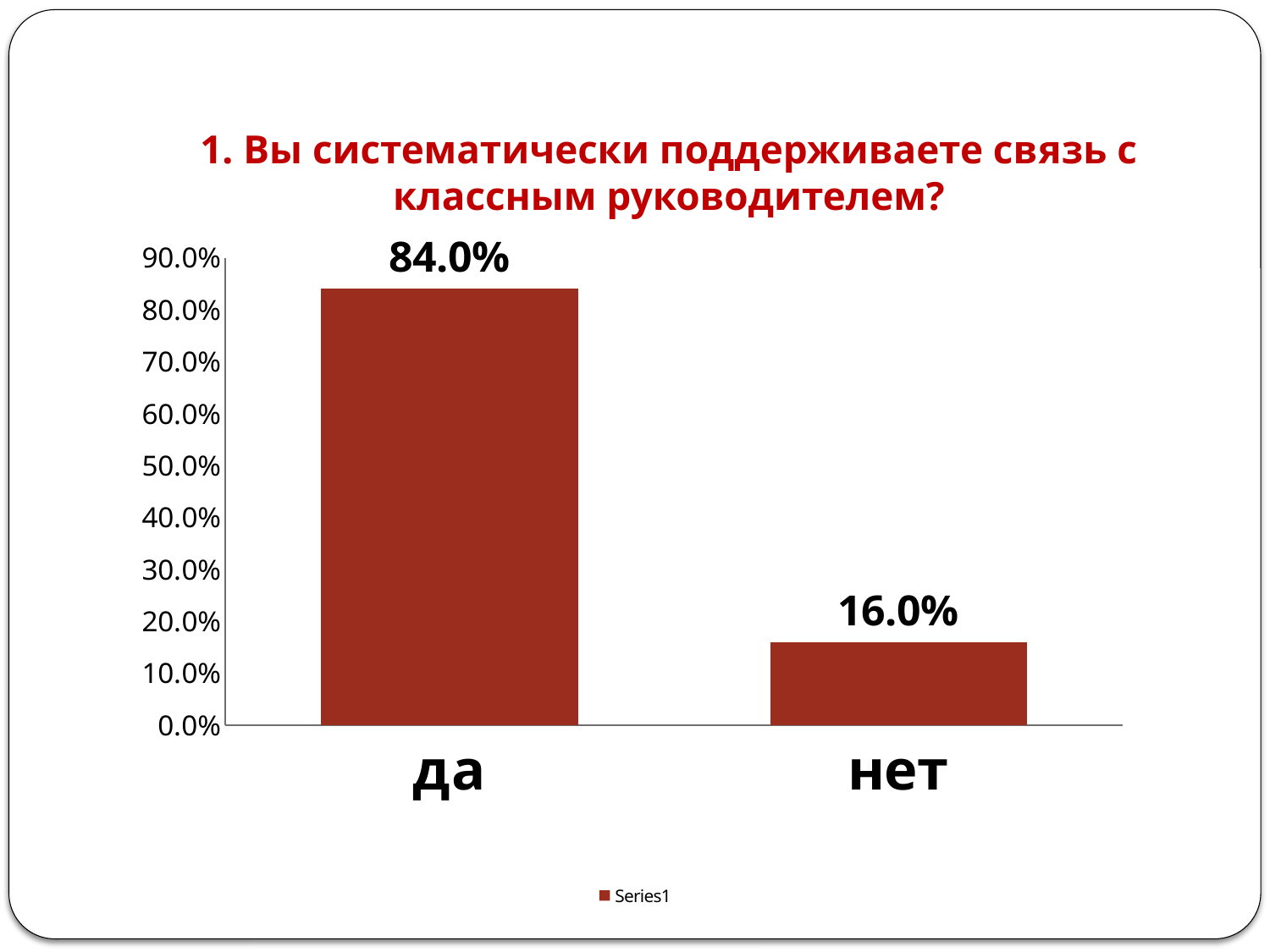
What is the name of the series shown in the legend? Series1 What kind of chart is shown on the slide? bar chart Which category has the highest value? да Which category has the lowest value? нет What is the value for "да"? 84.0% Is the value for "нет" greater or less than 20.0%? less What is the difference between the values for "да" and "нет"? 68.0% Is the value for "да" greater or less than 80.0%? greater How many series does the legend list? 1 What is the value for "нет"? 16.0% Which is larger, the value for "да" or the value for "нет"? да How many categories are shown on the x axis? 2